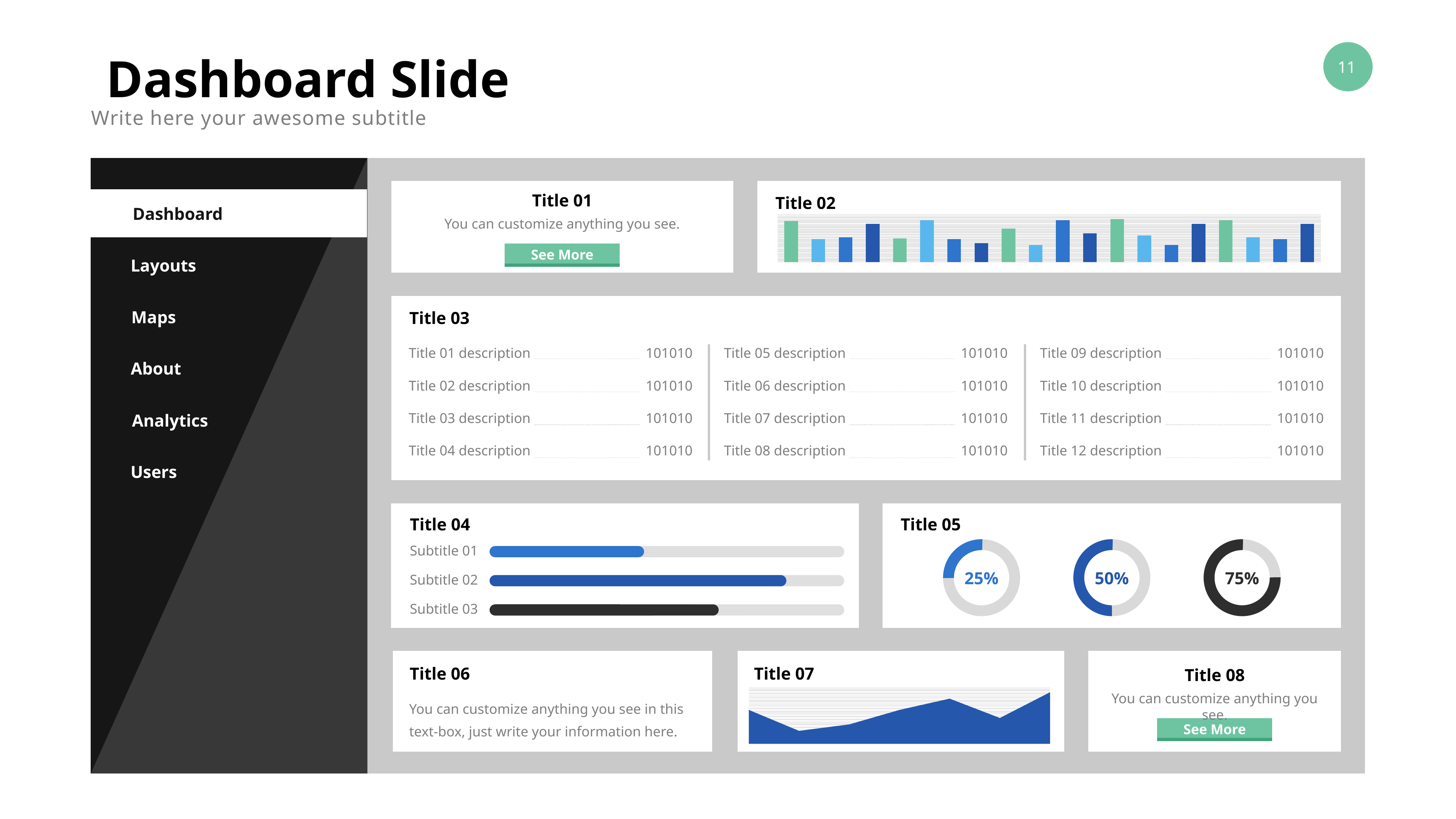
On the Title 05 chart, what value is shown in the first (leftmost) donut? 25% On the Title 05 chart, how many donut charts are shown? 3 On the Title 04 chart, how many progress bars are shown? 3 On the Title 05 chart, which donut shows the highest percentage? 75% On the Title 05 chart, what value is shown in the middle donut? 50% On the Title 05 chart, what is the difference between the rightmost donut's value and the leftmost donut's value? 50% What kind of chart is shown under Title 07? area chart On the Title 05 chart, what value is shown in the rightmost donut? 75% On the Title 05 chart, what colour is the ring of the 75% donut? black On the Title 05 chart, which donut shows the lowest percentage? 25% On the Title 04 chart, which bar is longer, Subtitle 01 or Subtitle 02? Subtitle 02 What kind of chart is shown under Title 02? bar chart